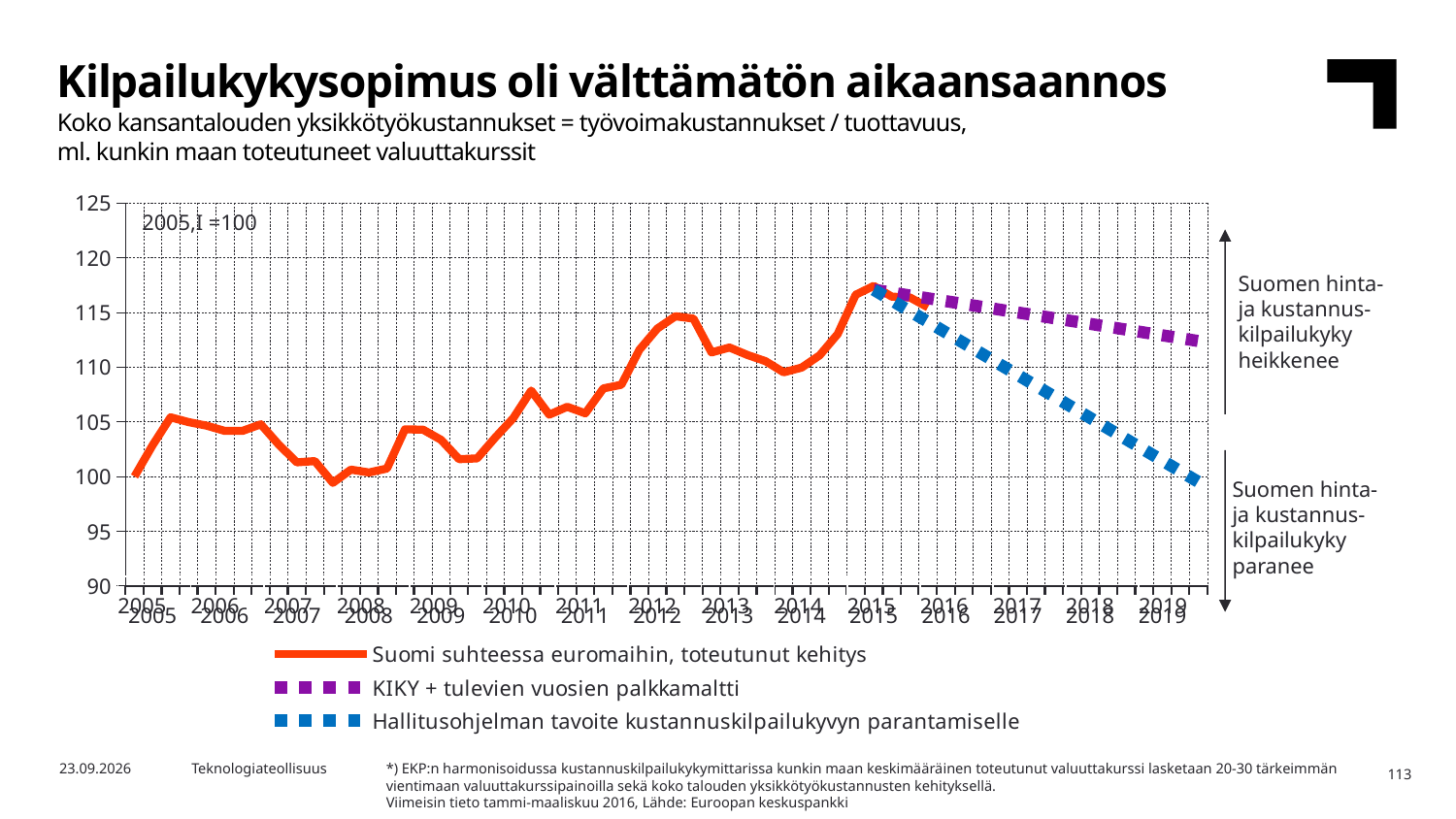
What colour is the 'Suomi suhteessa euromaihin, toteutunut kehitys' line? orange-red Is the value of the 'Hallitusohjelman tavoite kustannuskilpailukyvyn parantamiselle' line at the end of 2019 greater or less than 105? less What is the highest value shown on the y axis of the chart? 125 Is the value of the 'KIKY + tulevien vuosien palkkamaltti' line at the end of 2019 greater or less than 110? greater Does the 'Suomi suhteessa euromaihin, toteutunut kehitys' line rise or fall overall from 2005 to 2015? rise Is the value of the 'Suomi suhteessa euromaihin, toteutunut kehitys' line in 2008 greater or less than 105? less Does the 'Hallitusohjelman tavoite kustannuskilpailukyvyn parantamiselle' line rise or fall from 2015 to 2019? fall What kind of chart is shown on the slide? line chart In 2019, which line is higher: 'KIKY + tulevien vuosien palkkamaltti' or 'Hallitusohjelman tavoite kustannuskilpailukyvyn parantamiselle'? KIKY + tulevien vuosien palkkamaltti What is the index value at the start of 2005, according to the annotation on the chart? 100 How many series does the legend list? 3